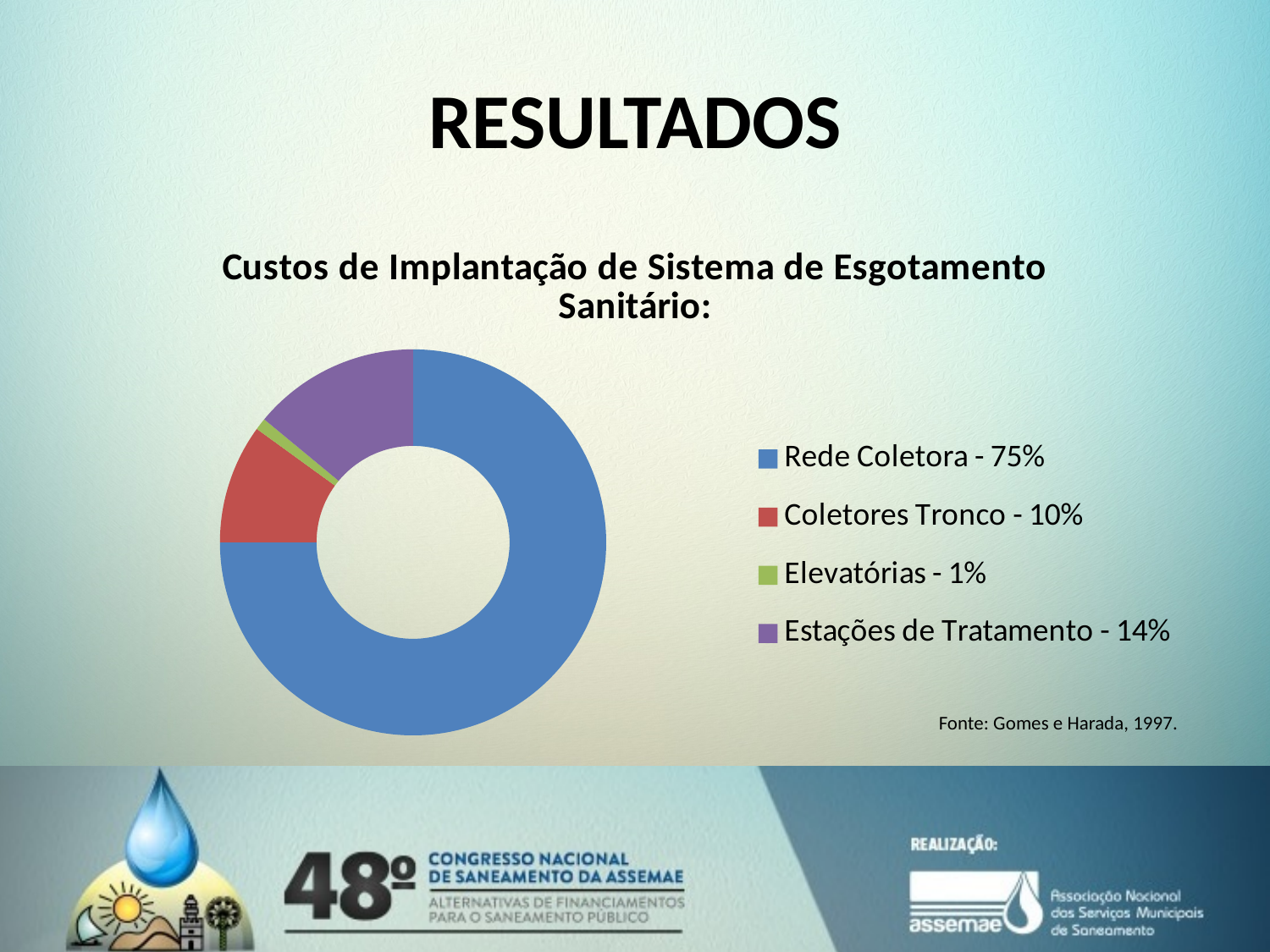
What share of the costs does Rede Coletora account for? 75% What share of the costs does Elevatórias account for? 1% What kind of chart is shown on the slide? Pie chart (doughnut) What share of the costs does Estações de Tratamento account for? 14% What is the difference in percentage points between Rede Coletora and Estações de Tratamento? 61 Which category has the smallest share of the costs? Elevatórias What is the title of the chart? Custos de Implantação de Sistema de Esgotamento Sanitário: Which is larger, the share for Coletores Tronco or the share for Estações de Tratamento? Estações de Tratamento Which category has the largest share of the costs? Rede Coletora What colour represents Estações de Tratamento in the chart? Purple How many categories does the chart show? 4